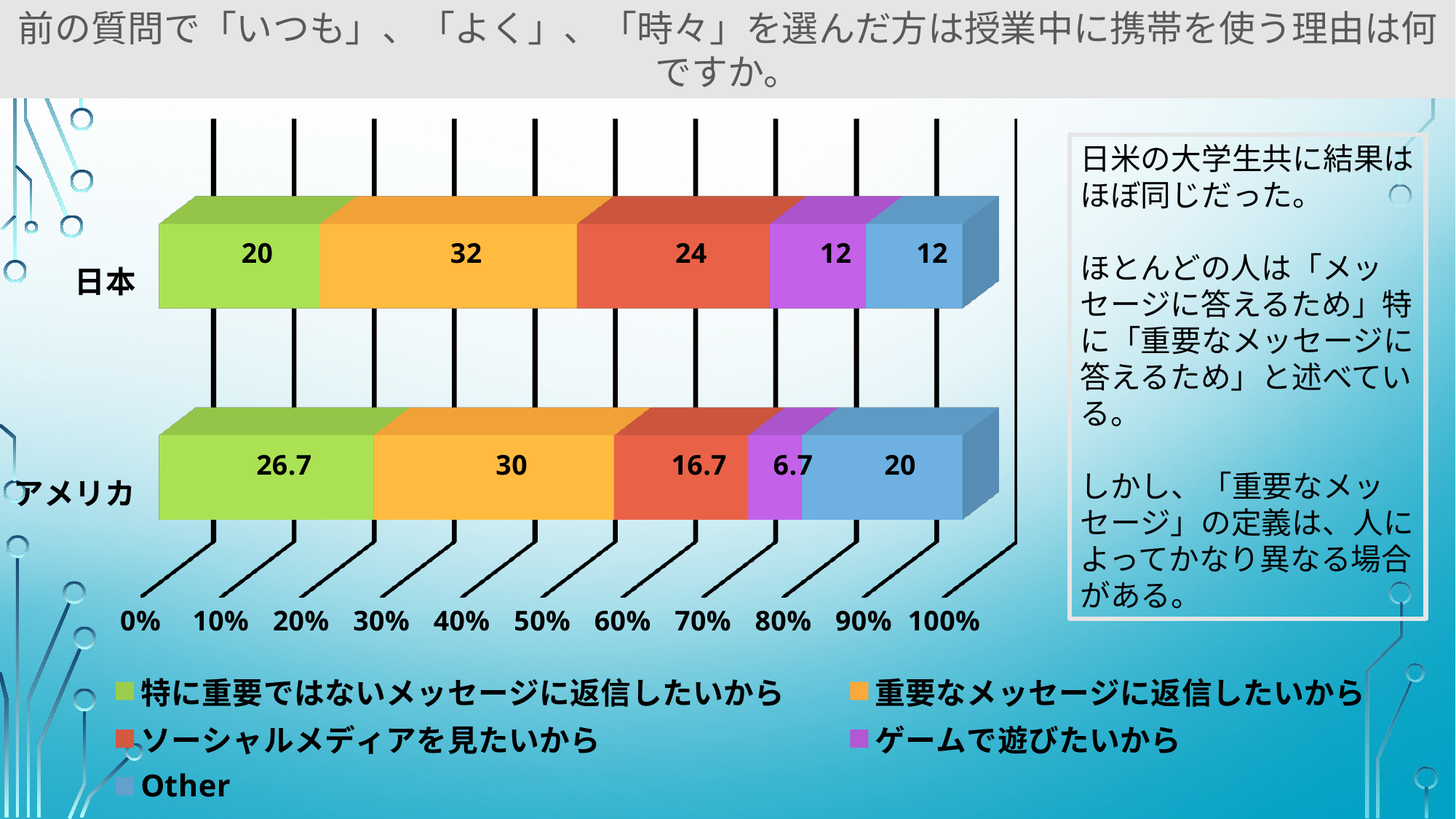
What kind of chart is shown on the slide? Stacked bar chart What is the value for 特に重要ではないメッセージに返信したいから for アメリカ? 26.7 Which reason has the lowest value for アメリカ? ゲームで遊びたいから What is the value for 重要なメッセージに返信したいから for 日本? 32 What is the value for Other for 日本? 12 How many series does the legend list? 5 What is the difference between the ソーシャルメディアを見たいから values for 日本 and アメリカ? 7.3 What is the total of the stacked bar for 日本? 100 Which is larger: the Other value for 日本 or for アメリカ? アメリカ Which reason has the highest value for 日本? 重要なメッセージに返信したいから What is the value for ゲームで遊びたいから for アメリカ? 6.7 How many categories (countries) are shown on the chart? 2